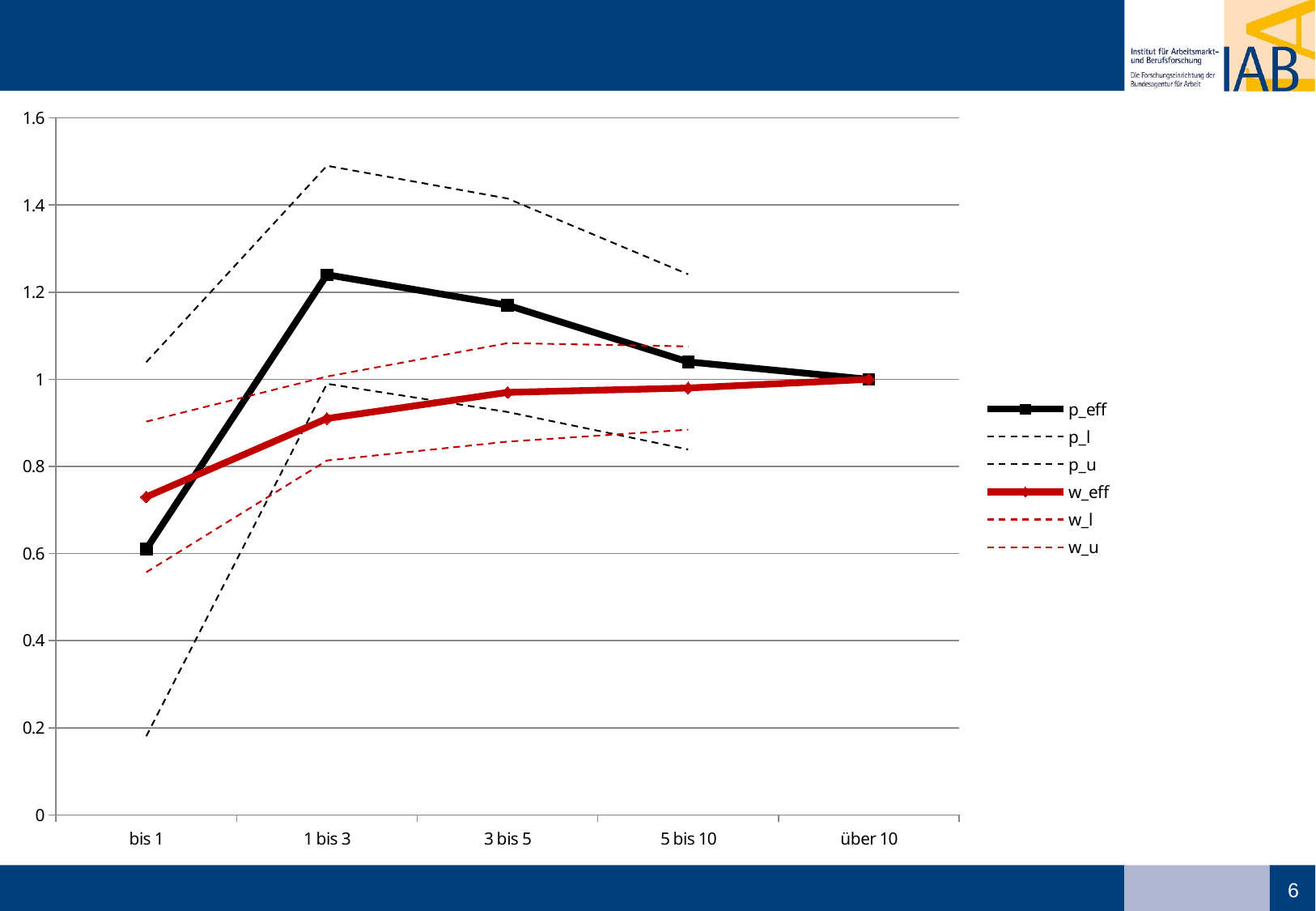
Is the value of w_eff at bis 1 greater or less than 0.8? less What kind of chart is shown on the slide? line chart Is the value of p_u at 1 bis 3 greater or less than 1.4? greater At which category does the p_eff series reach its highest value? 1 bis 3 How many series does the legend list? 6 How many categories are shown on the x axis? 5 Is the value of p_eff at 1 bis 3 greater or less than 1.2? greater At which category does the w_eff series have its lowest value? bis 1 At which category does the p_eff series have its lowest value? bis 1 Does the w_eff series rise or fall from bis 1 to über 10? rise Which series is drawn as a thick red line in the legend? w_eff At bis 1, which series has the larger value, p_eff or w_eff? w_eff